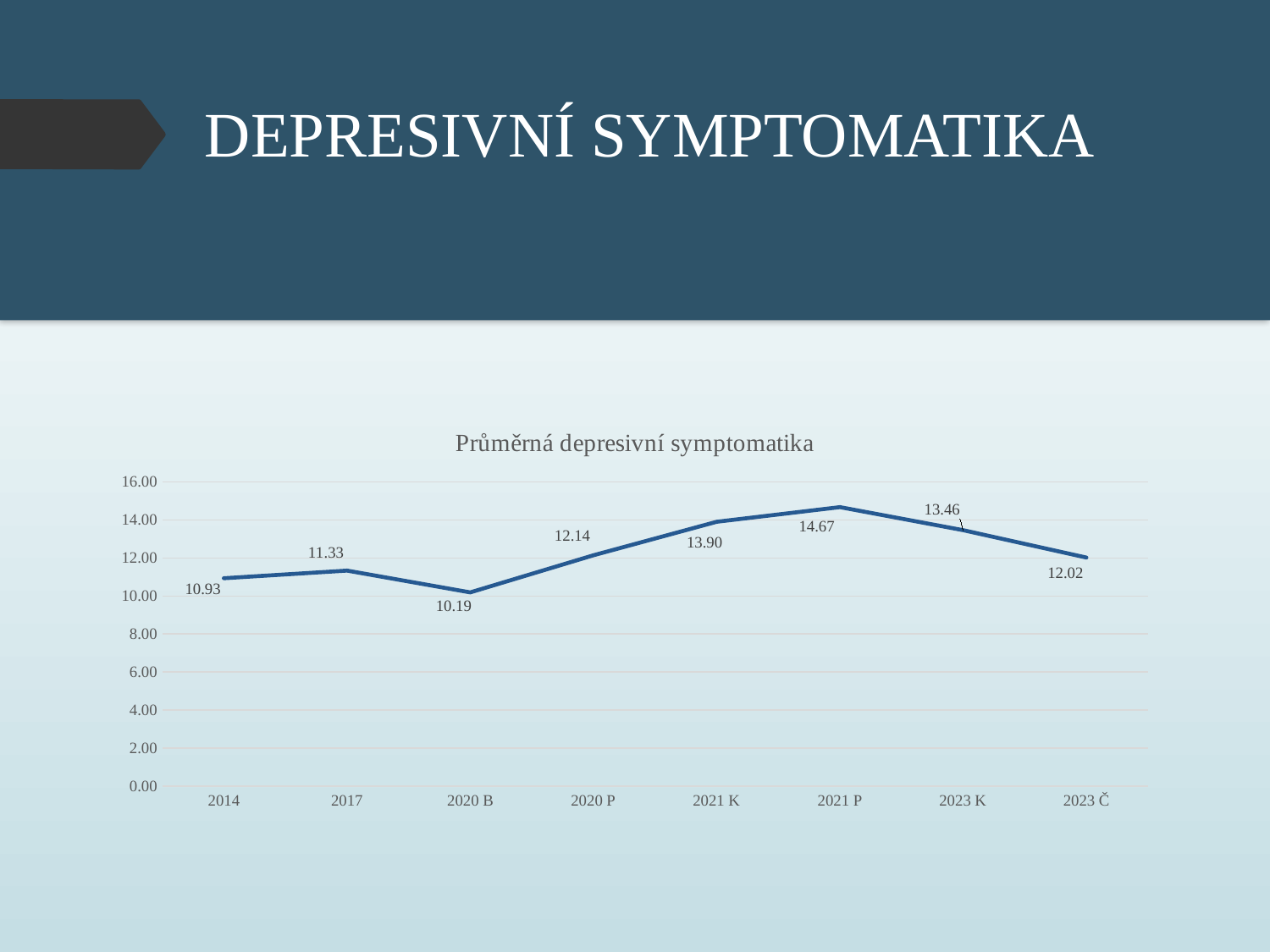
How many categories are shown on the x axis? 8 Which category has the lowest value? 2020 B What is the value for 2021 P? 14.67 What is the difference between the values for 2021 P and 2020 B? 4.48 What is the value for 2023 Č? 12.02 Which is larger, the value for 2017 or the value for 2020 P? 2020 P Is the value for 2021 K greater or less than 12.00? greater What kind of chart is this? line chart Do the values rise or fall from 2020 B to 2021 P? rise What is the title of the chart? Průměrná depresivní symptomatika What is the value for 2014? 10.93 Which category has the highest value? 2021 P